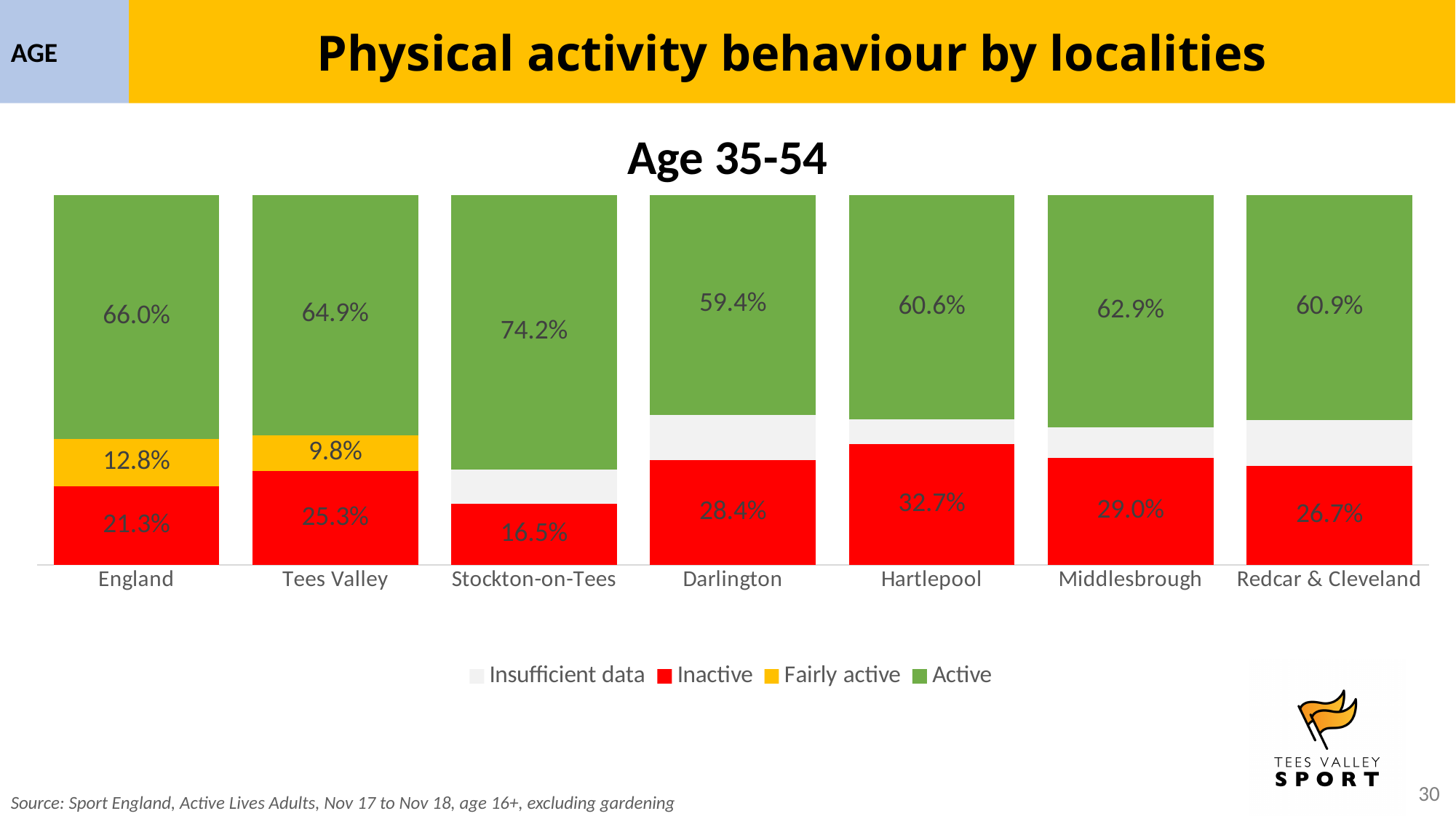
What is the difference between the Inactive values for Hartlepool and England? 11.4% What is the Inactive value for Hartlepool? 32.7% Which has a higher Active value, Middlesbrough or Redcar & Cleveland? Middlesbrough What is the Fairly active value for England? 12.8% Which locality has the lowest Active value? Darlington Which locality has the lowest Inactive value? Stockton-on-Tees What kind of chart is shown on the slide? Stacked bar chart Which locality has the highest Active value? Stockton-on-Tees How many series does the legend list? 4 What is the Active value for Stockton-on-Tees? 74.2% Which colour represents the Inactive series? Red How many localities are shown on the x axis? 7